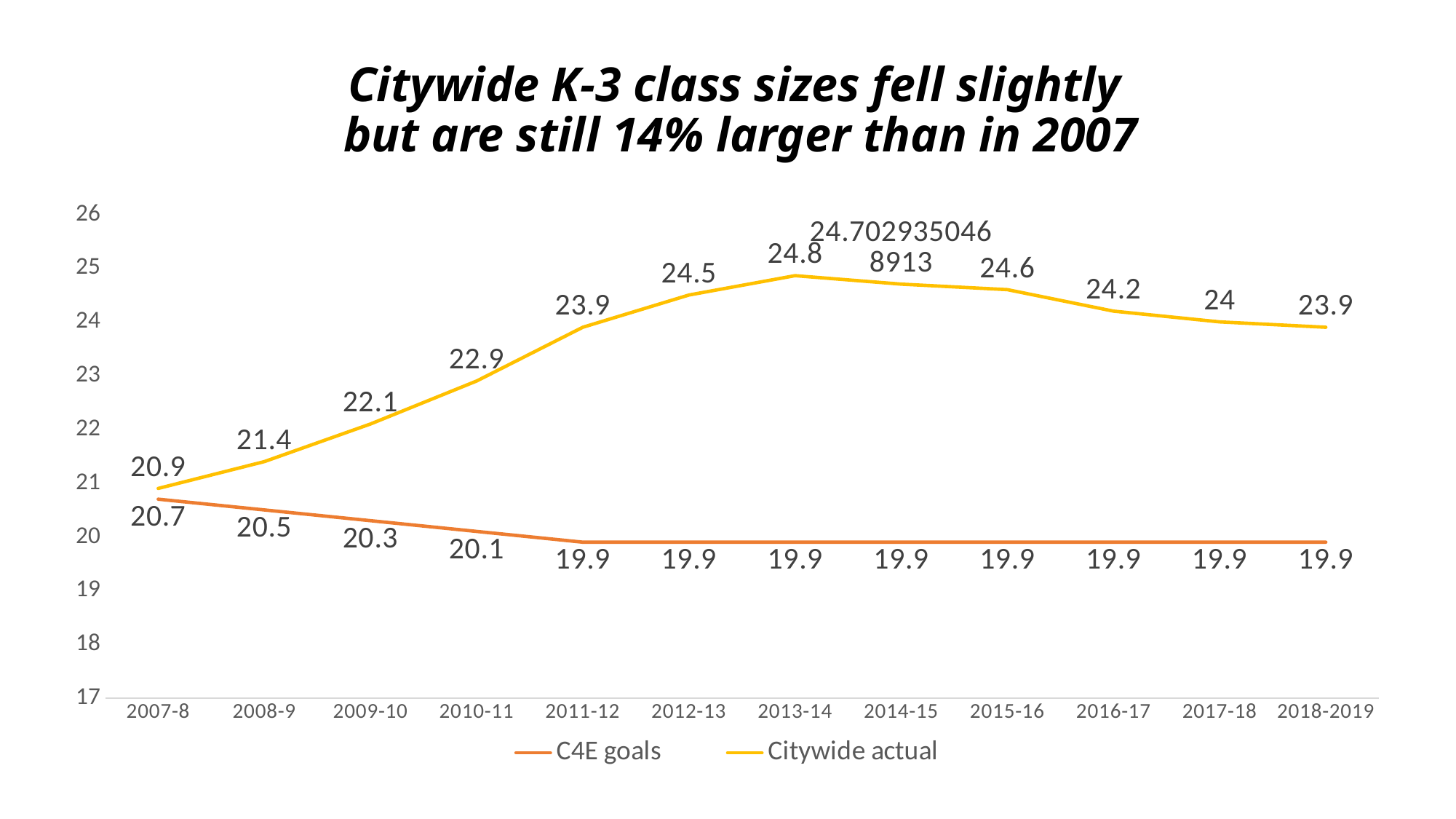
What is the C4E goals value for 2009-10? 20.3 What is the Citywide actual value for 2007-8? 20.9 What is the difference between the Citywide actual and C4E goals values in 2013-14? 4.9 How many series does the legend list? 2 Which is larger in 2010-11, the Citywide actual value or the C4E goals value? Citywide actual What is the Citywide actual value for 2014-15? 24.7029350468913 Does the C4E goals line rise or fall from 2007-8 to 2011-12? Fall What kind of chart is shown on the slide? Line chart In which school year is the Citywide actual value lowest? 2007-8 What is the Citywide actual value for 2018-2019? 23.9 How many school years are shown on the x axis? 12 In which school year is the Citywide actual value highest? 2013-14